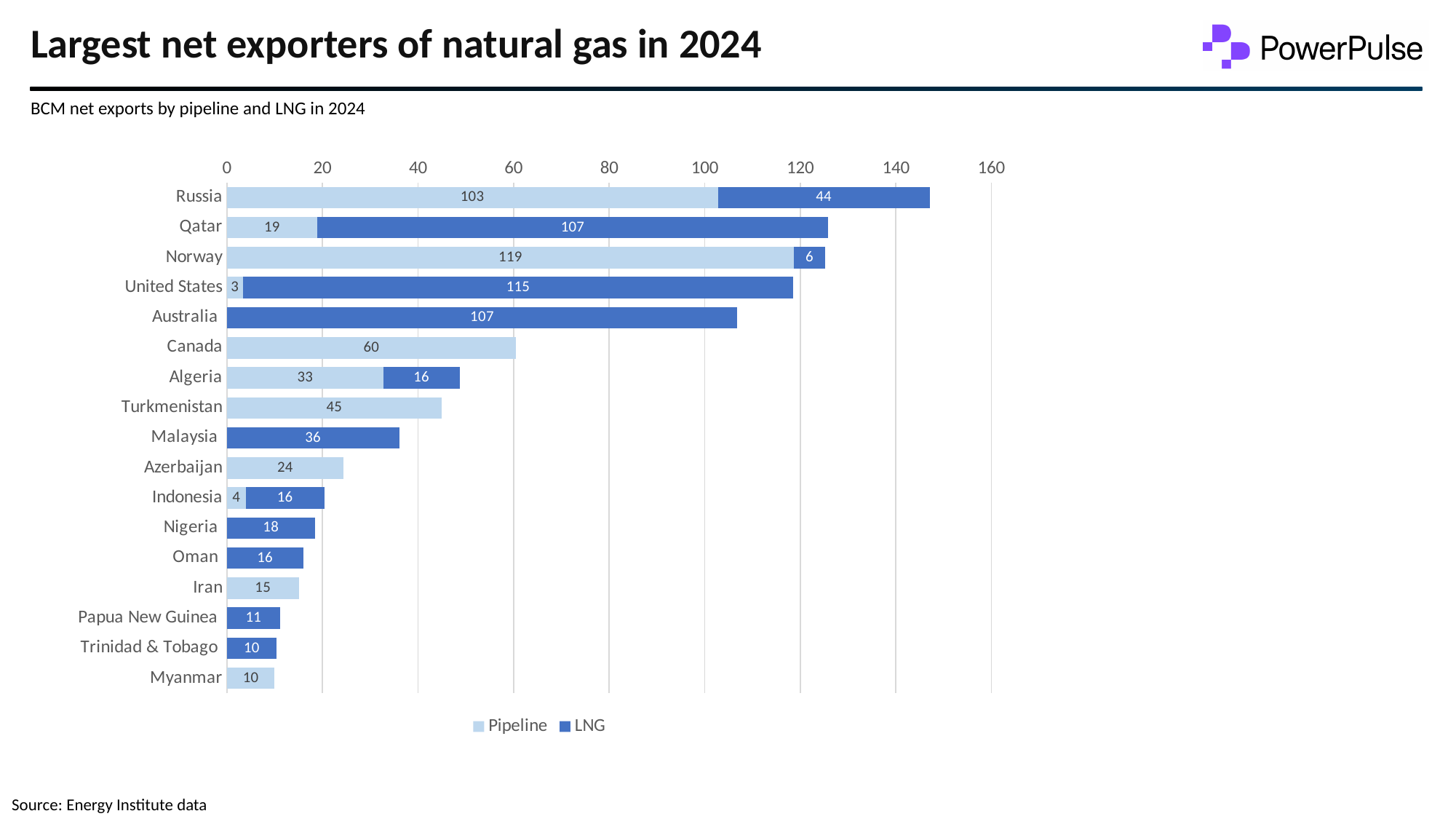
What is the total net export value for Algeria (Pipeline plus LNG)? 49 Is the total bar length for Russia greater or less than 140? greater How many countries are shown in the chart? 17 Which has the larger Pipeline value, Canada or Turkmenistan? Canada What is the total net export value for Russia (Pipeline plus LNG)? 147 What kind of chart is shown on the slide? Stacked bar chart How many series does the legend list? 2 What is the LNG value for Norway? 6 What is the Pipeline value for Russia? 103 Which country has the highest Pipeline value? Norway How much larger is Qatar's LNG value than Russia's LNG value? 63 What is the LNG value for Qatar? 107